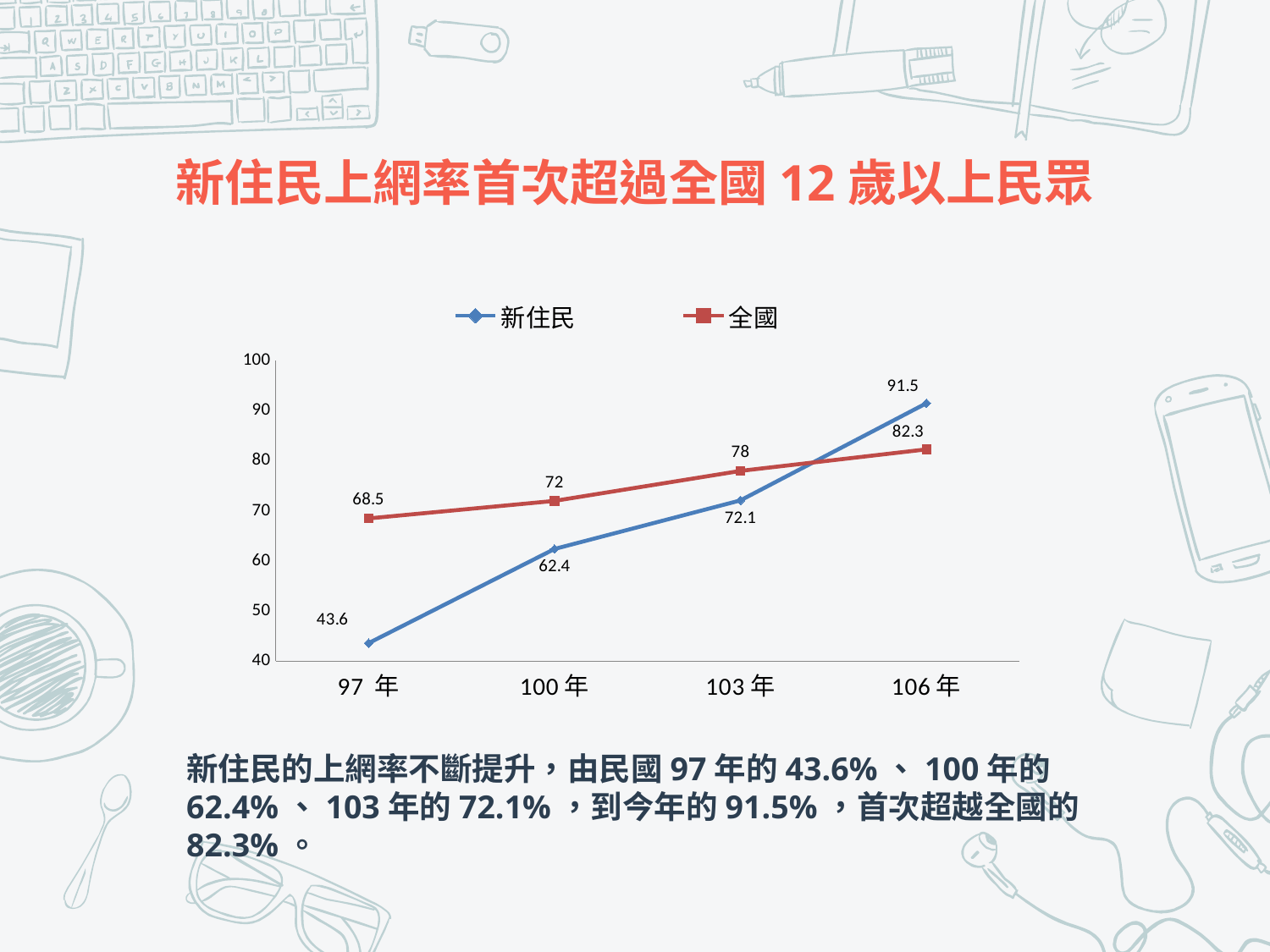
How many years are shown on the x axis? 4 What is the difference between 新住民 and 全國 in 106 年? 9.2 Which series has the larger value in 103 年, 新住民 or 全國? 全國 Do the 新住民 values rise or fall from 97 年 to 106 年? rise In which year is the 新住民 value highest? 106 年 What is the value for 全國 in 100 年? 72 In which year is the 全國 value lowest? 97 年 What is the value for 全國 in 103 年? 78 What kind of chart is shown on the slide? line chart What is the value for 新住民 in 106 年? 91.5 What is the value for 新住民 in 97 年? 43.6 How many series does the legend list? 2